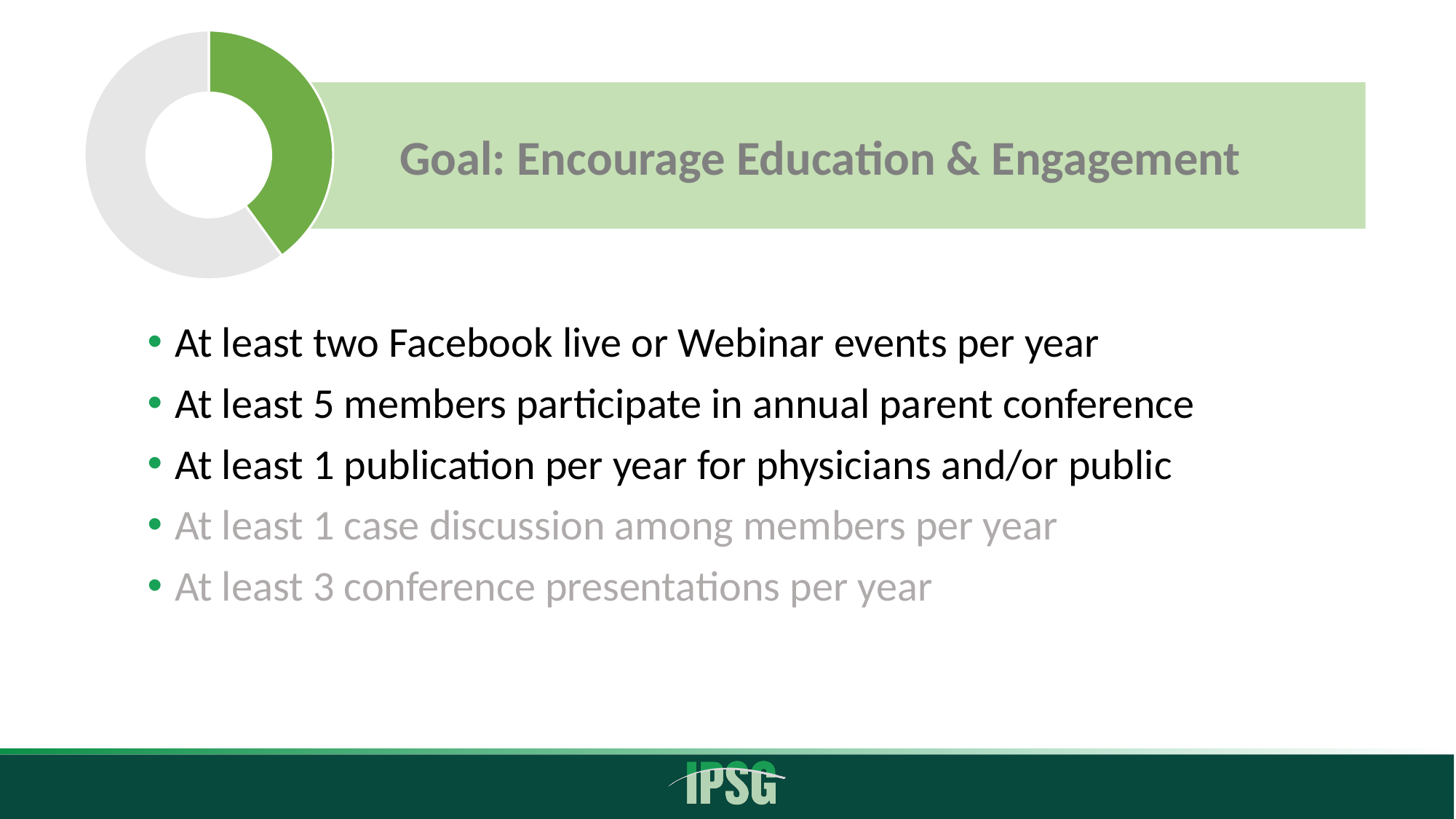
Does the doughnut chart display any data labels or a legend? No In the doughnut chart, which slice is the smallest? The green slice How many slices does the doughnut chart in the top-left corner have? 2 In the doughnut chart, which slice is larger, the green one or the grey one? The grey one What kind of chart is shown in the top-left corner of the slide? Doughnut chart What two colours are used for the slices of the doughnut chart? Green and grey Is the green slice of the doughnut chart more or less than half of the ring? Less